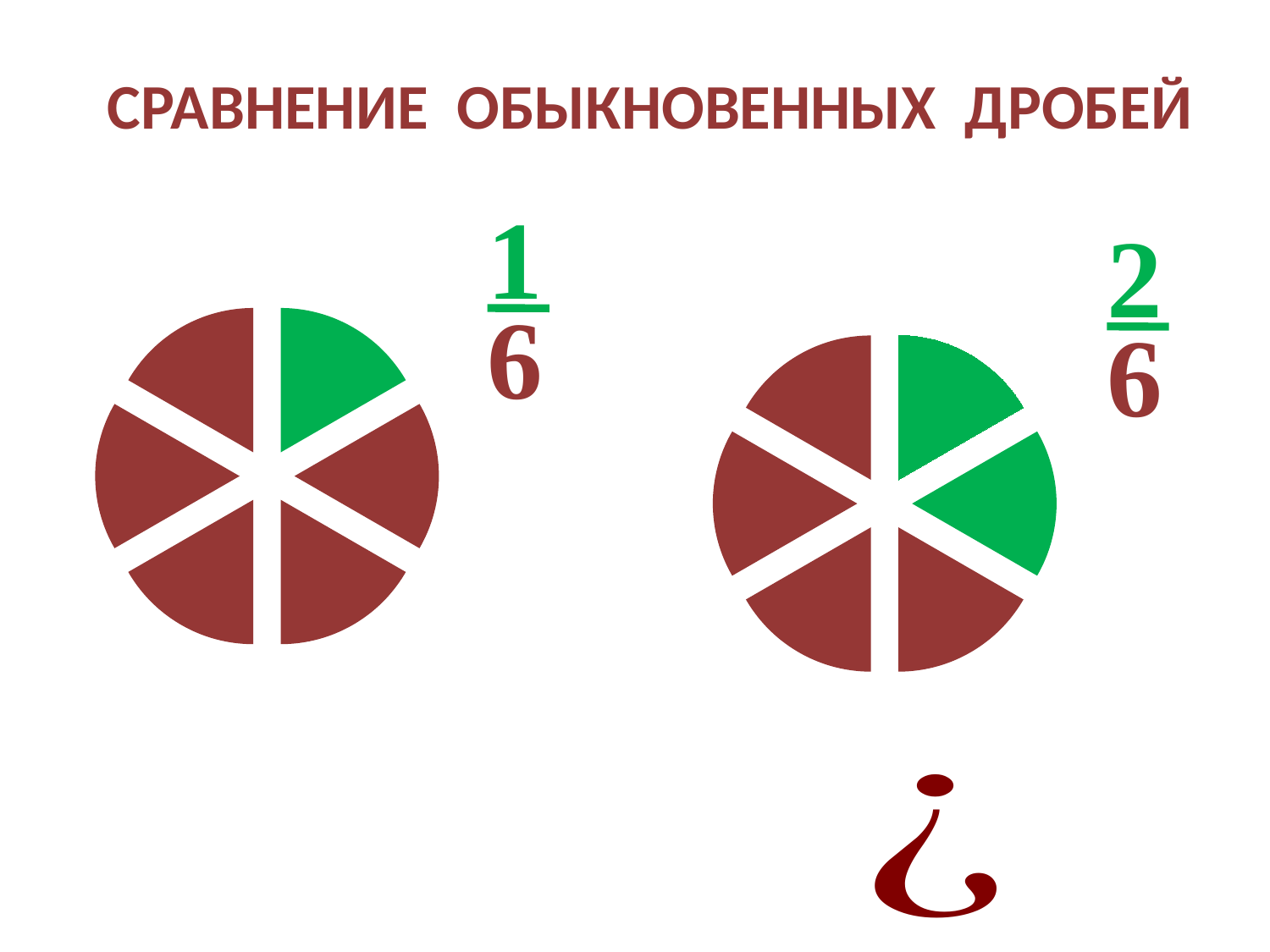
What share of the left pie chart is green? 1/6 What fraction is printed next to the right pie chart? 2/6 What is the title of the slide? СРАВНЕНИЕ ОБЫКНОВЕННЫХ ДРОБЕЙ What kind of chart is the right chart on the slide? pie chart What kind of chart is the left chart on the slide? pie chart In the left pie chart, how many slices are green? 1 Which pie chart has the larger green share, the left one or the right one? the right one What share of the right pie chart is green? 2/6 What fraction is printed next to the left pie chart? 1/6 How many slices does the right pie chart have? 6 In the right pie chart, how many slices are green? 2